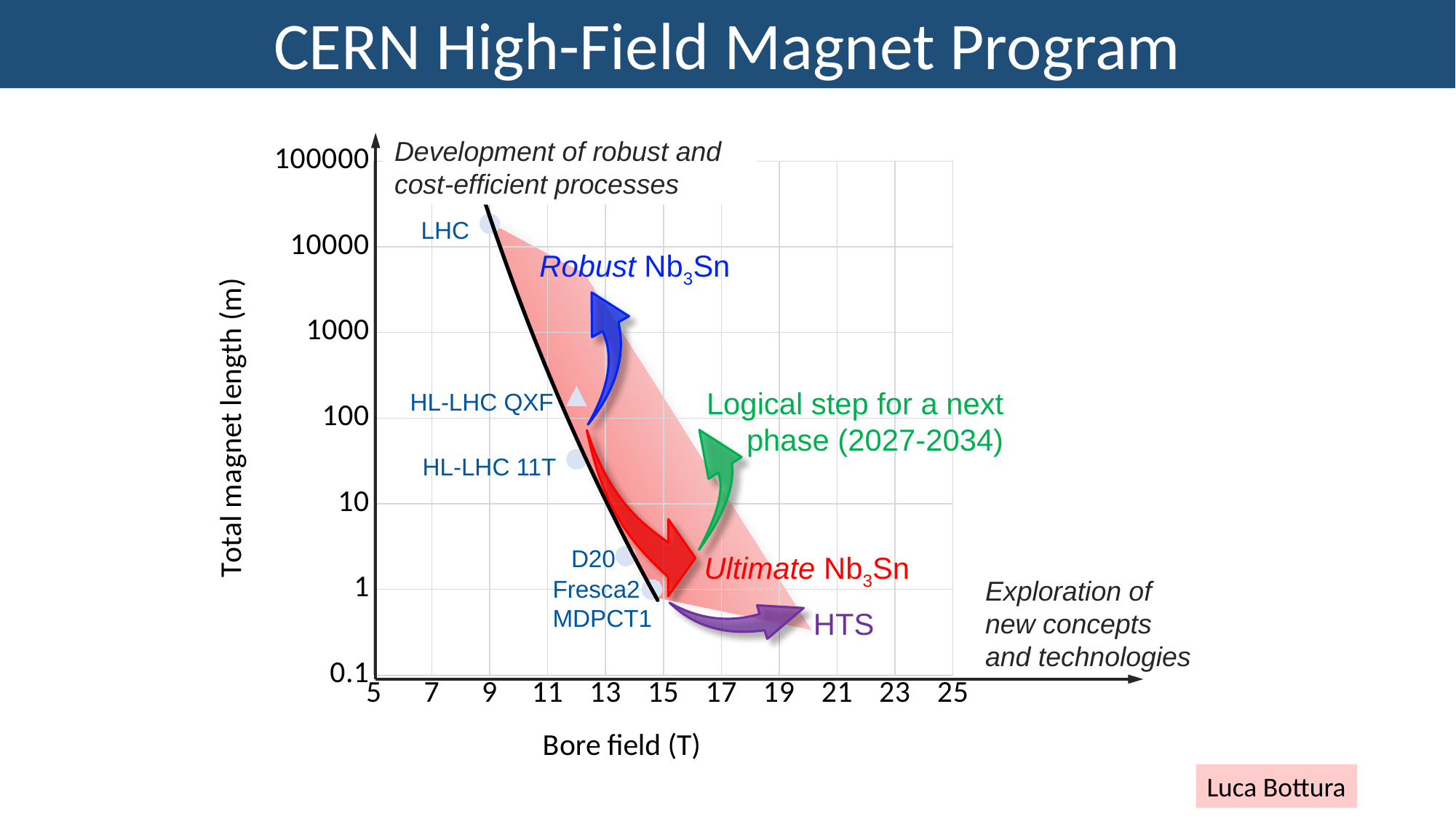
What is the label of the y axis of the chart? Total magnet length (m) Is the total magnet length for HL-LHC QXF greater or less than 100? greater Is the total magnet length for D20 greater or less than 10? less Which has the larger total magnet length, HL-LHC QXF or HL-LHC 11T? HL-LHC QXF Is the total magnet length for LHC greater or less than 10000? greater Which labeled magnet has the lowest bore field? LHC Which labeled magnet has the greatest total magnet length? LHC How many labeled magnets are plotted on the chart? 6 What is the label of the x axis of the chart? Bore field (T) What kind of chart is shown on the slide? scatter chart